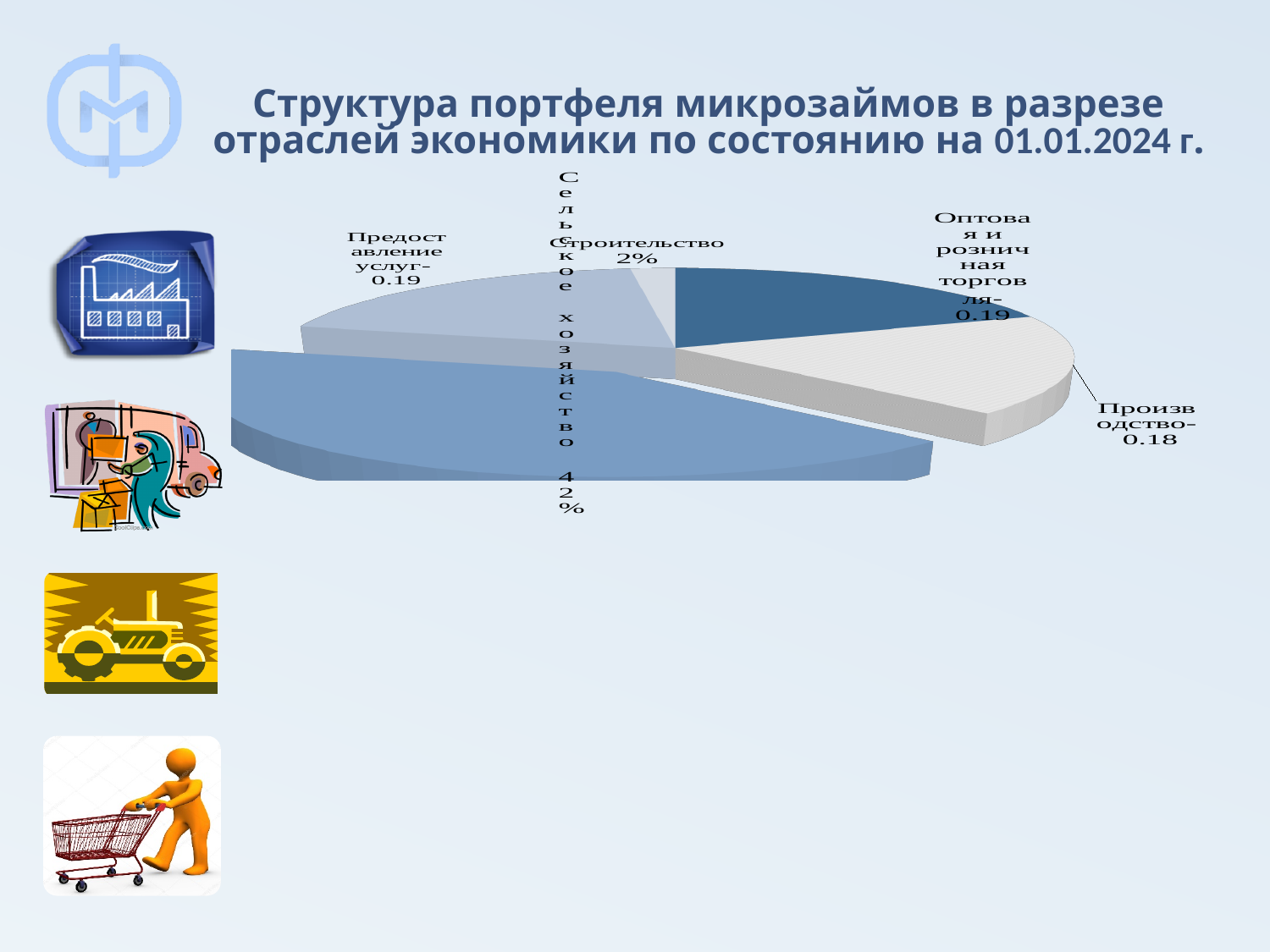
What is the value shown for Оптовая и розничная торговля? 0.19 How many slices does the pie chart have? 5 What is the value shown for Строительство? 2% What is the value shown for Производство? 0.18 What kind of chart is shown on the slide? pie chart Which is larger, the share for Сельское хозяйство or for Производство? Сельское хозяйство Which sector has the smallest share of the microloan portfolio? Строительство As of what date does the chart title say the portfolio structure is shown? 01.01.2024 г. What is the value shown for Сельское хозяйство? 42% Which sector has the largest share of the microloan portfolio? Сельское хозяйство What is the value shown for Предоставление услуг? 0.19 What is the difference between the shares for Сельское хозяйство and Строительство? 40%